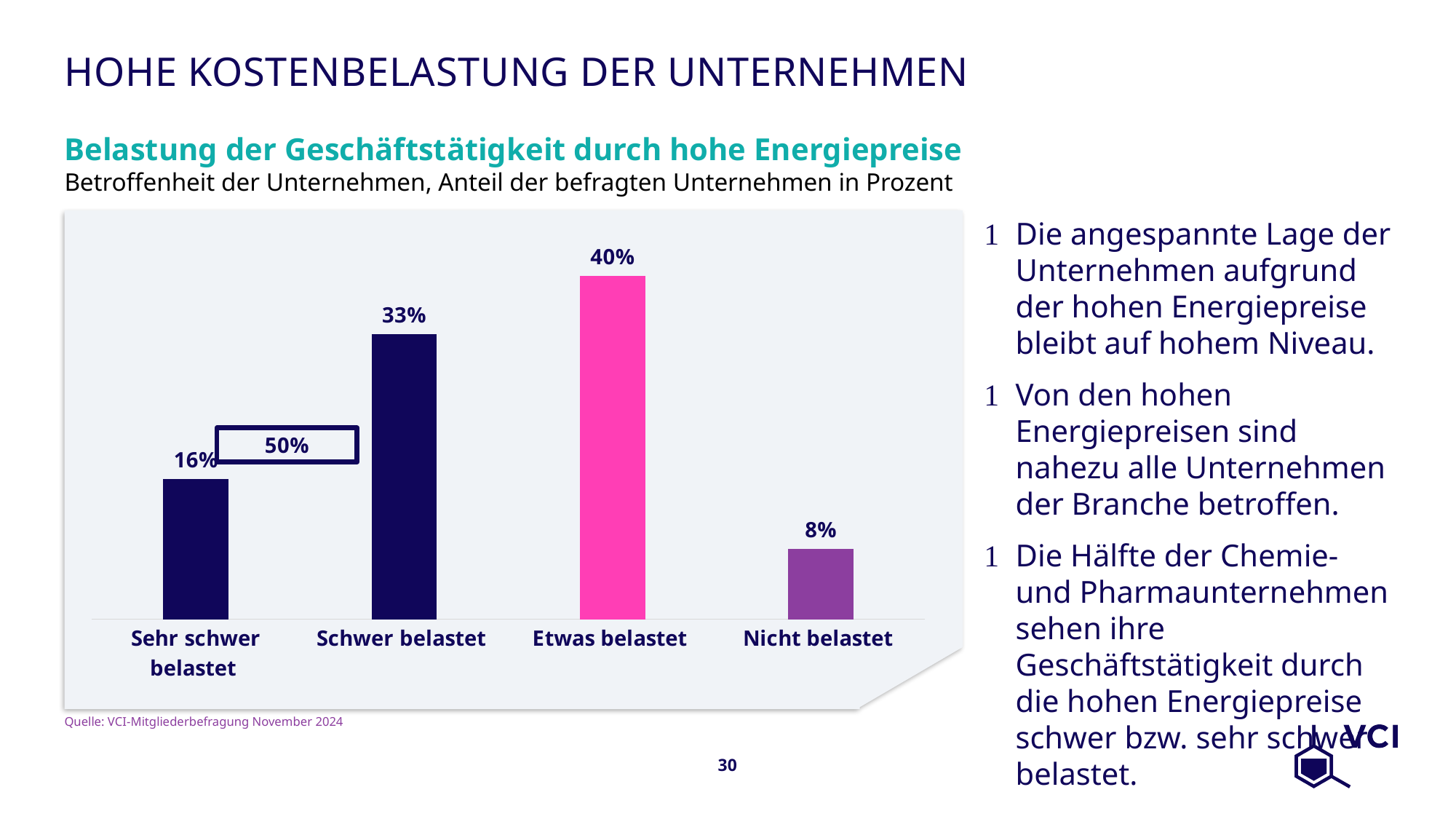
How many categories are shown in the chart? 4 What kind of chart is shown on the slide? Bar chart What is the difference between the values for "Sehr schwer belastet" and "Nicht belastet"? 8% What is the value for "Sehr schwer belastet"? 16% What is the difference between the values for "Etwas belastet" and "Schwer belastet"? 7% Which category has the highest value? Etwas belastet What value is shown in the box bracketing the first two bars? 50% What is the value for "Schwer belastet"? 33% Which category has the lowest value? Nicht belastet What is the value for "Nicht belastet"? 8% What is the value for "Etwas belastet"? 40% Which is larger, the value for "Schwer belastet" or the value for "Sehr schwer belastet"? Schwer belastet